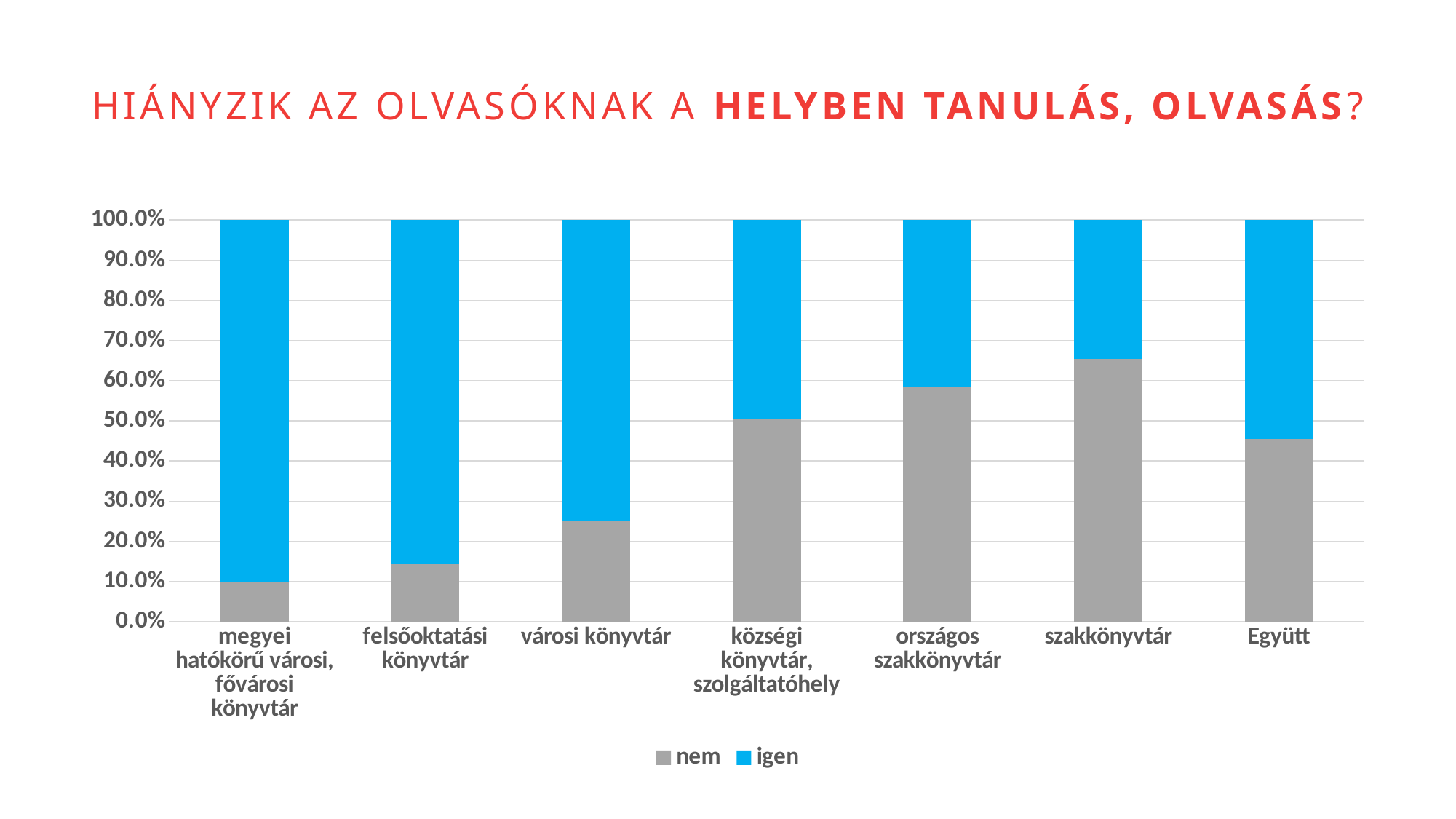
How many categories are shown along the x axis of the chart? 7 What kind of chart is shown on the slide? stacked bar chart Is the 'nem' share for városi könyvtár greater or less than 30.0%? less Which category has the smallest 'nem' share? megyei hatókörű városi, fővárosi könyvtár What is the total of the stacked bar for Együtt? 100.0% What are the two series named in the legend? nem, igen How many series does the legend list? 2 Is the 'nem' share for szakkönyvtár greater or less than 60.0%? greater Which colour represents the 'igen' series? blue Is the 'nem' share for Együtt greater or less than 50.0%? less Which category has the largest 'nem' share? szakkönyvtár Which has the larger 'nem' share: községi könyvtár, szolgáltatóhely or városi könyvtár? községi könyvtár, szolgáltatóhely